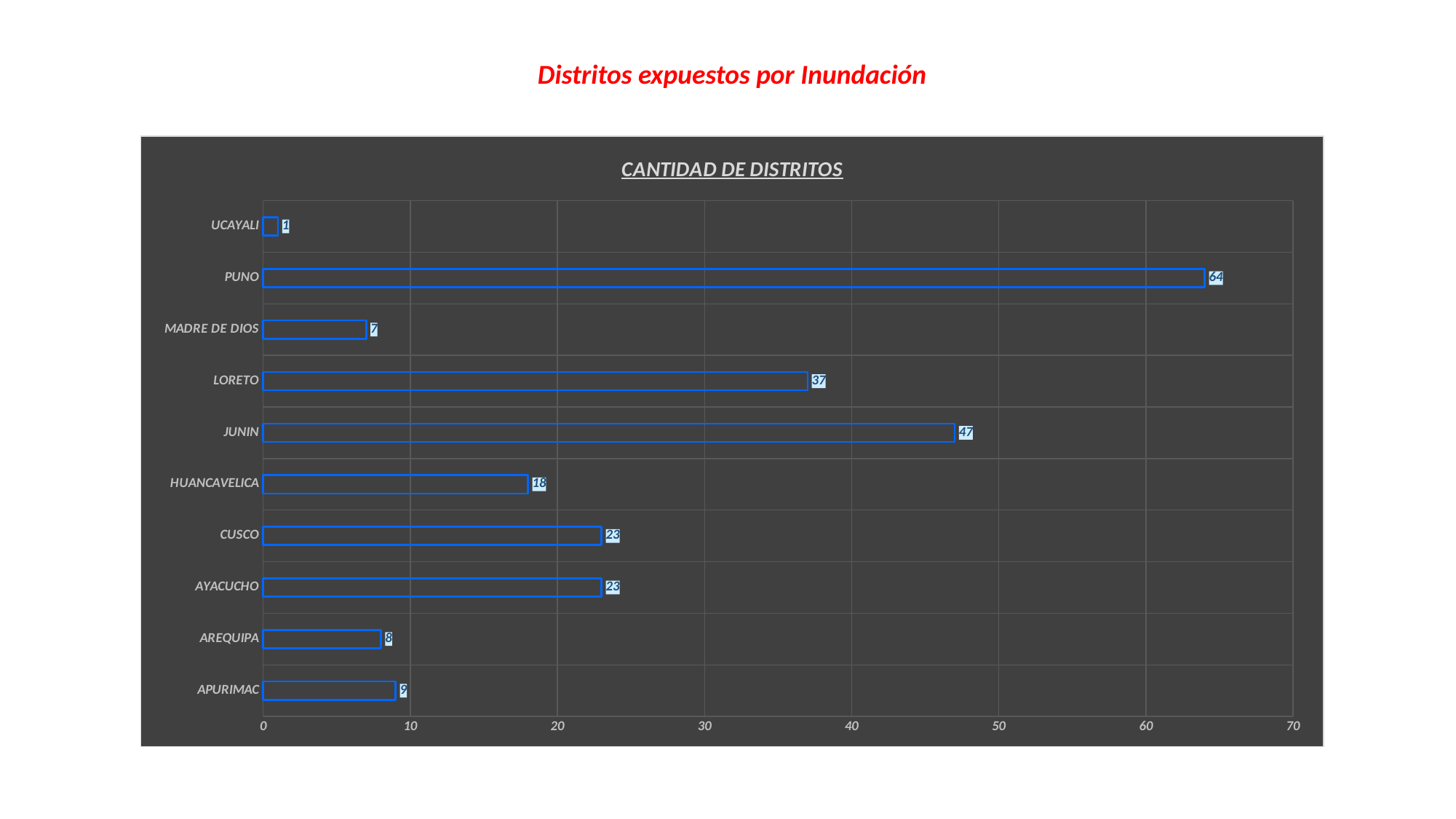
What is the title of the chart? CANTIDAD DE DISTRITOS What is the value for LORETO? 37 What kind of chart is shown on the slide? bar chart What is the value for HUANCAVELICA? 18 Is the value for JUNIN greater or less than 40? greater What is the value for PUNO? 64 Which category has the highest value? PUNO Which is larger, the value for APURIMAC or the value for AREQUIPA? APURIMAC How many categories are shown in the chart? 10 What is the value for MADRE DE DIOS? 7 What is the difference between the values for JUNIN and LORETO? 10 Which category has the lowest value? UCAYALI